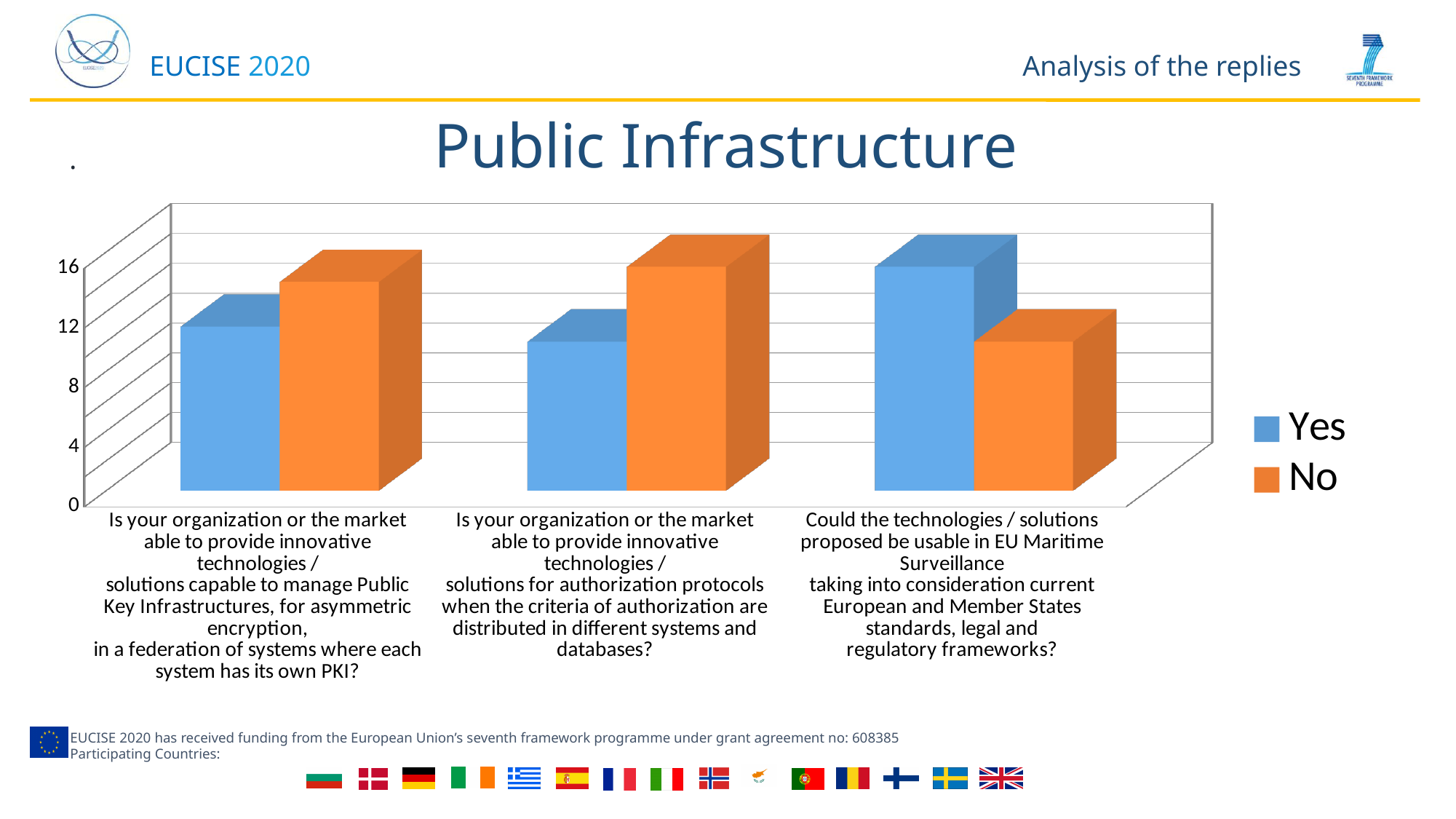
How many series does the legend list? 2 What are the two series named in the legend? Yes and No Is the 'Yes' value for the third question (about EU Maritime Surveillance standards) greater or less than 12? greater For the third question (about EU Maritime Surveillance standards), which is larger, Yes or No? Yes For the first question (about Public Key Infrastructures), which is larger, Yes or No? No Which question has the highest 'Yes' value? Could the technologies / solutions proposed be usable in EU Maritime Surveillance taking into consideration current European and Member States standards, legal and regulatory frameworks? For the second question (about authorization protocols), which is larger, Yes or No? No Is the 'No' value for the first question (about Public Key Infrastructures) greater or less than 12? greater Is the 'No' value for the second question (about authorization protocols) greater or less than 12? greater Which colour represents the 'No' series? orange What kind of chart is shown on the slide? bar chart How many questions (categories) are plotted on the chart? 3